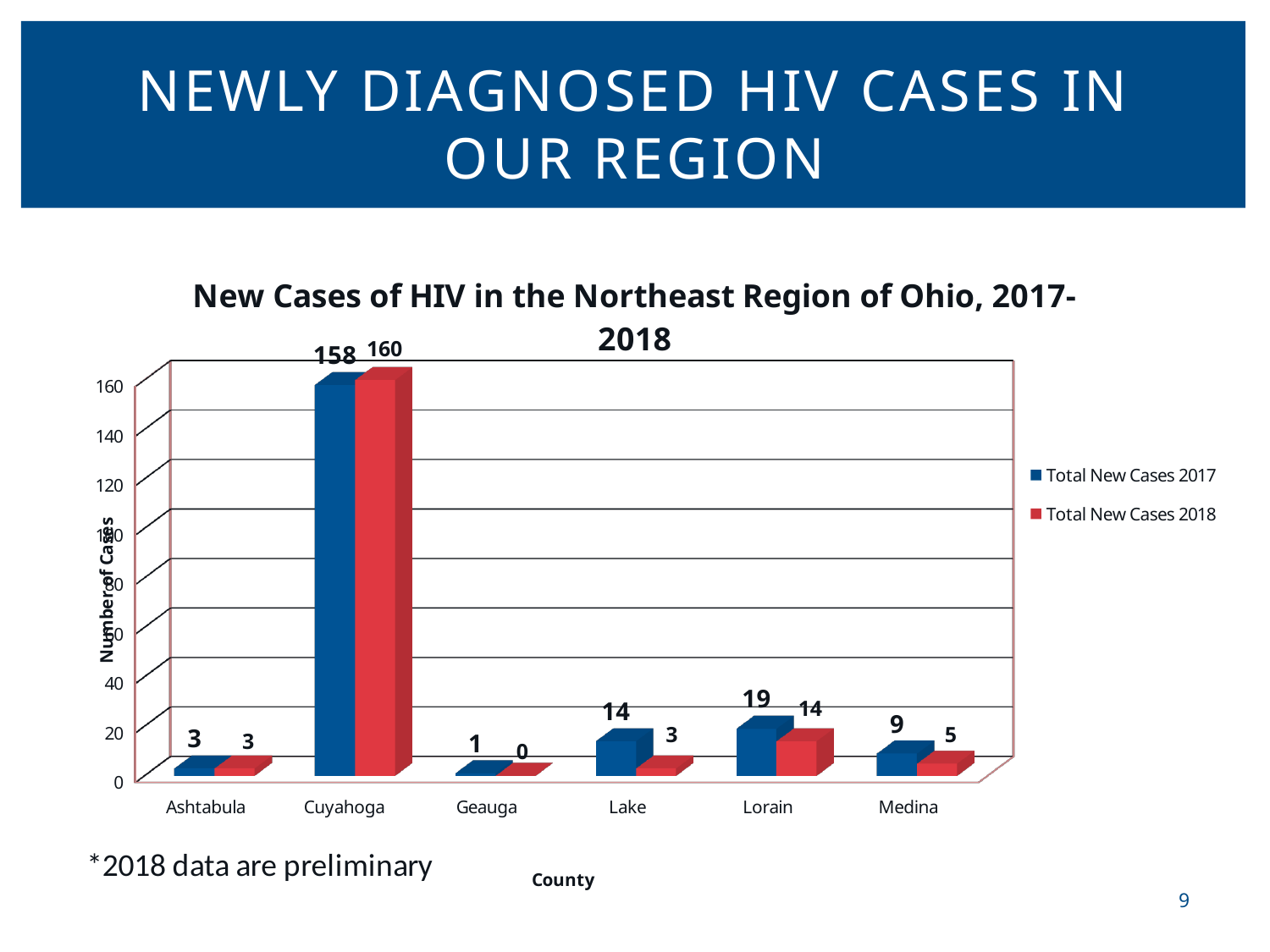
Which county has the lowest value for Total New Cases 2017? Geauga What is the value for Total New Cases 2018 in Geauga? 0 What is the title of the chart? New Cases of HIV in the Northeast Region of Ohio, 2017-2018 How many counties are shown on the x axis? 6 How many series does the legend list? 2 What kind of chart is shown on the slide? Bar chart What is the difference between Total New Cases 2018 and Total New Cases 2017 in Cuyahoga? 2 Which county has the highest value for Total New Cases 2018? Cuyahoga What is the value for Total New Cases 2018 in Lake? 3 Which is larger in Medina: Total New Cases 2017 or Total New Cases 2018? Total New Cases 2017 What is the difference between Total New Cases 2017 and Total New Cases 2018 in Lorain? 5 What is the value for Total New Cases 2017 in Cuyahoga? 158